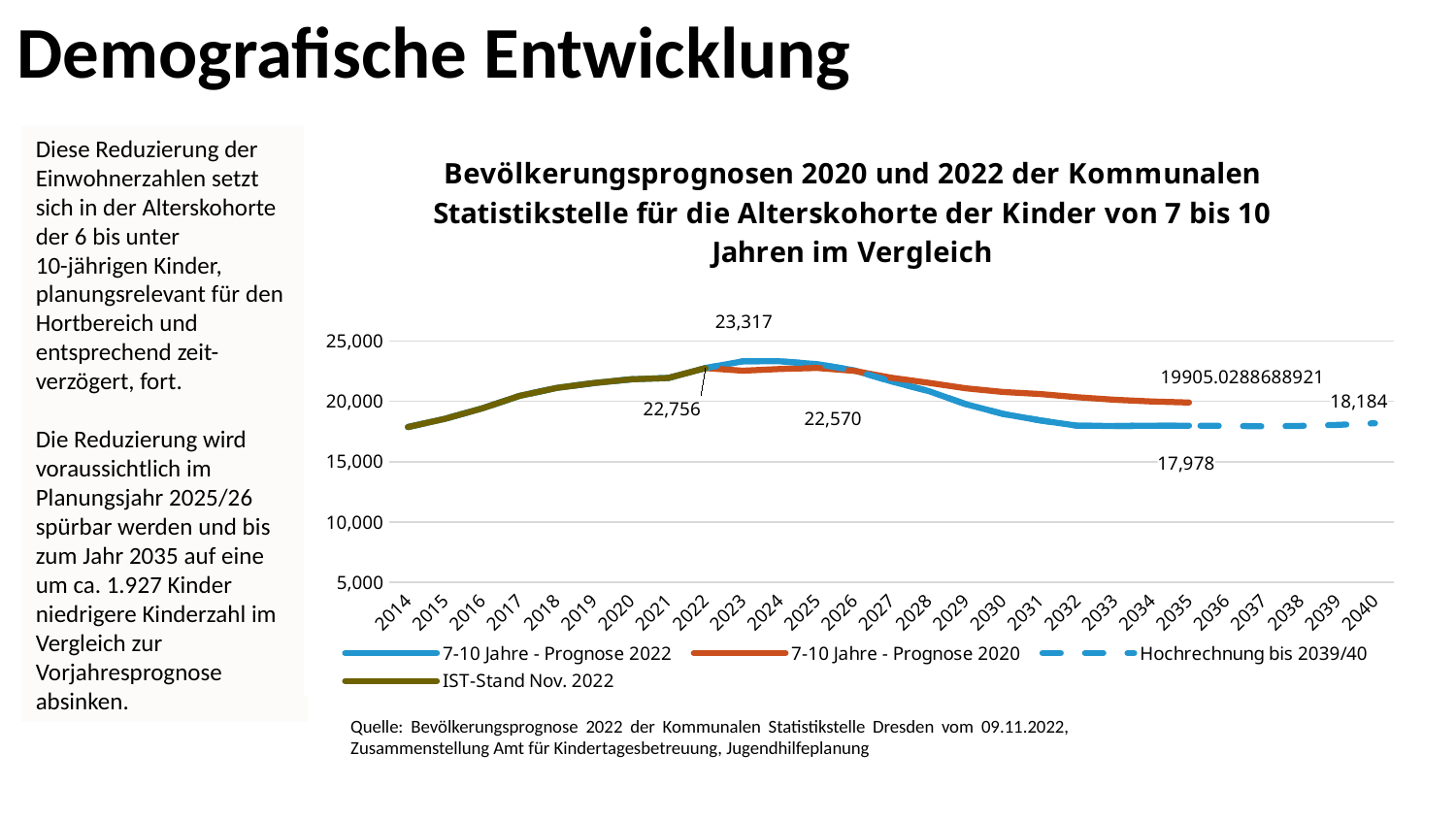
Is the value of the 7-10 Jahre - Prognose 2020 series in 2030 greater or less than 20,000? greater How many years are shown on the x axis of the chart? 27 What is the highest data label shown on the chart? 23,317 What is the value of the 7-10 Jahre - Prognose 2020 series in 2035? 19905.0288688921 What is the value of the Hochrechnung bis 2039/40 series in 2040? 18,184 How many series does the chart legend list? 4 In 2035, which series has the larger value: 7-10 Jahre - Prognose 2020 or 7-10 Jahre - Prognose 2022? 7-10 Jahre - Prognose 2020 Is the value of the IST-Stand Nov. 2022 series in 2014 greater or less than 20,000? less Which series in the legend is drawn as a dashed line? Hochrechnung bis 2039/40 Does the 7-10 Jahre - Prognose 2022 series rise or fall between 2024 and 2035? fall What is the value of the 7-10 Jahre - Prognose 2022 series in 2035? 17,978 What kind of chart is shown on the slide? line chart